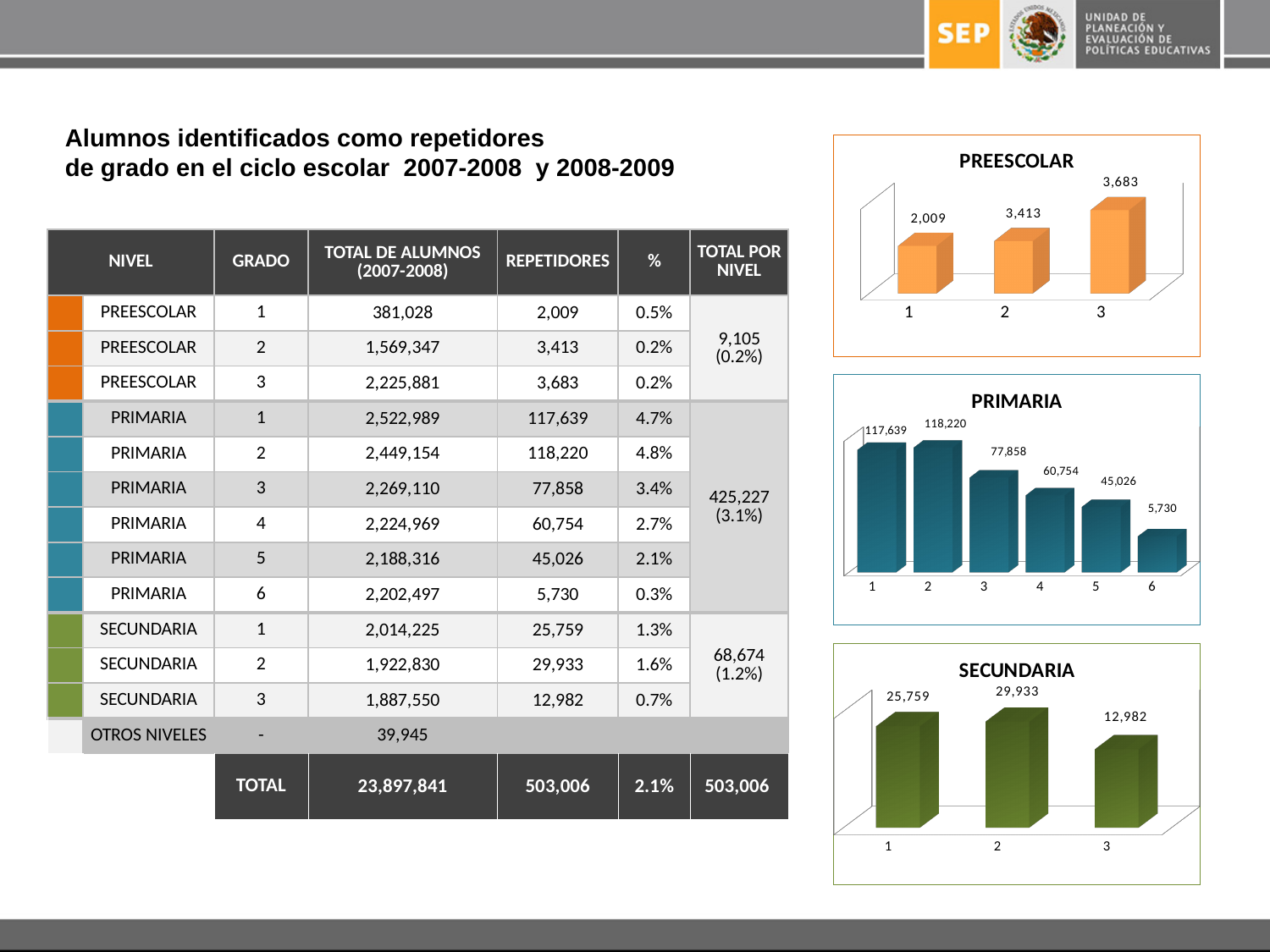
What type of chart is the SECUNDARIA chart? bar chart In the PRIMARIA chart, what is the value for grade 4? 60,754 In the PRIMARIA chart, do the values generally rise or fall from grade 2 to grade 6? fall In the SECUNDARIA chart, what is the value for grade 2? 29,933 In the PREESCOLAR chart, which grade has the lowest value? 1 In the SECUNDARIA chart, which is larger, the value for grade 1 or grade 3? grade 1 In the PRIMARIA chart, how many grades are plotted? 6 In the PRIMARIA chart, which grade has the highest value? 2 In the PREESCOLAR chart, what is the difference between the values for grade 2 and grade 1? 1,404 In the SECUNDARIA chart, what is the difference between the values for grade 2 and grade 3? 16,951 In the PRIMARIA chart, which grade has the lowest value? 6 In the PREESCOLAR chart, what is the value for grade 3? 3,683